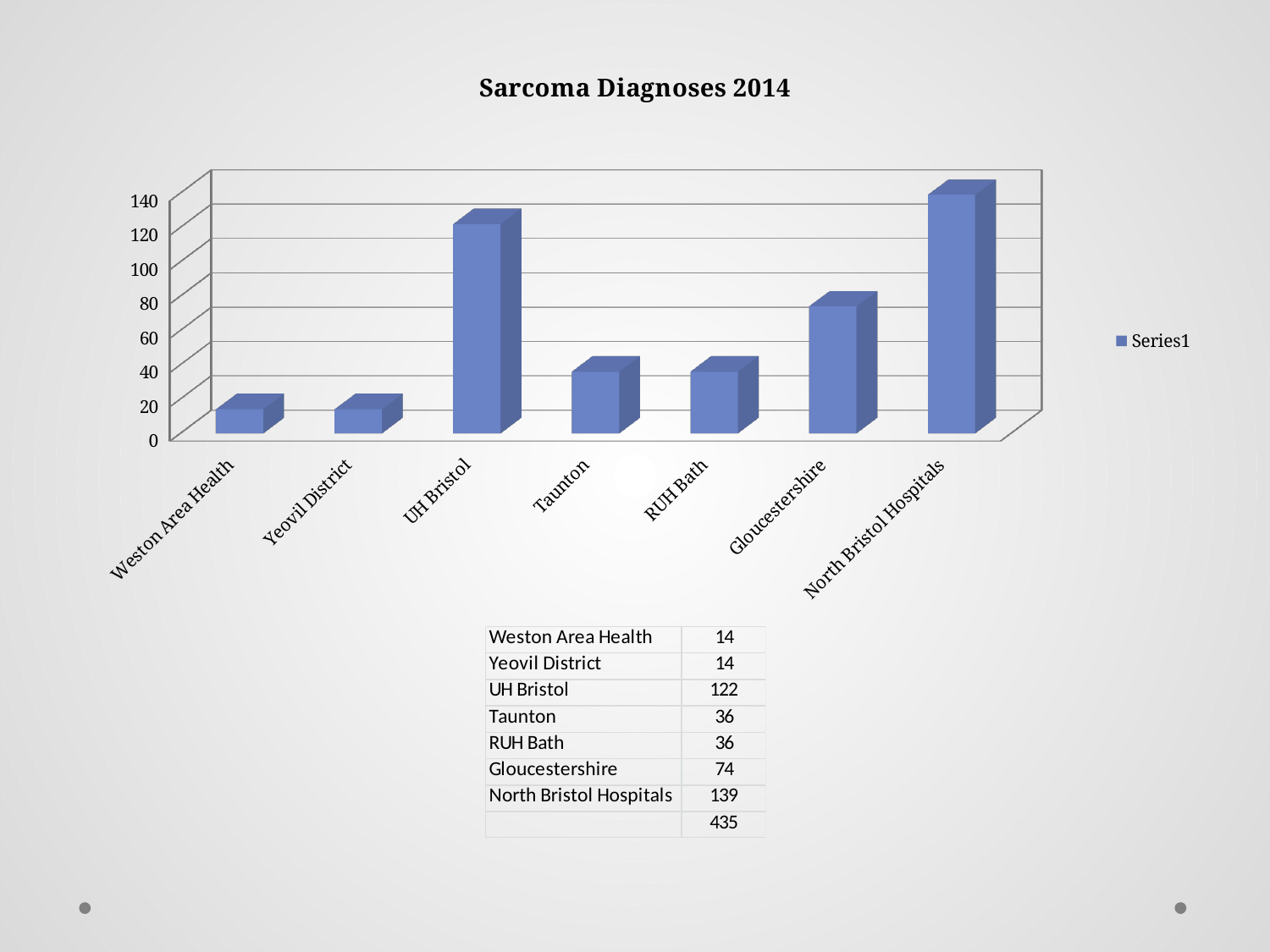
What is the value for North Bristol Hospitals? 139 Which is larger, the value for Gloucestershire or the value for Taunton? Gloucestershire Which category has the highest number of sarcoma diagnoses? North Bristol Hospitals How many hospitals/categories are plotted on the x axis? 7 What kind of chart is shown on the slide? bar chart What is the value for Gloucestershire? 74 What is the title of the chart? Sarcoma Diagnoses 2014 What is the total of all the values shown in the table? 435 Is the value for UH Bristol greater or less than 100? greater What is the value for UH Bristol? 122 What is the difference between North Bristol Hospitals and UH Bristol? 17 How many series does the legend list? 1